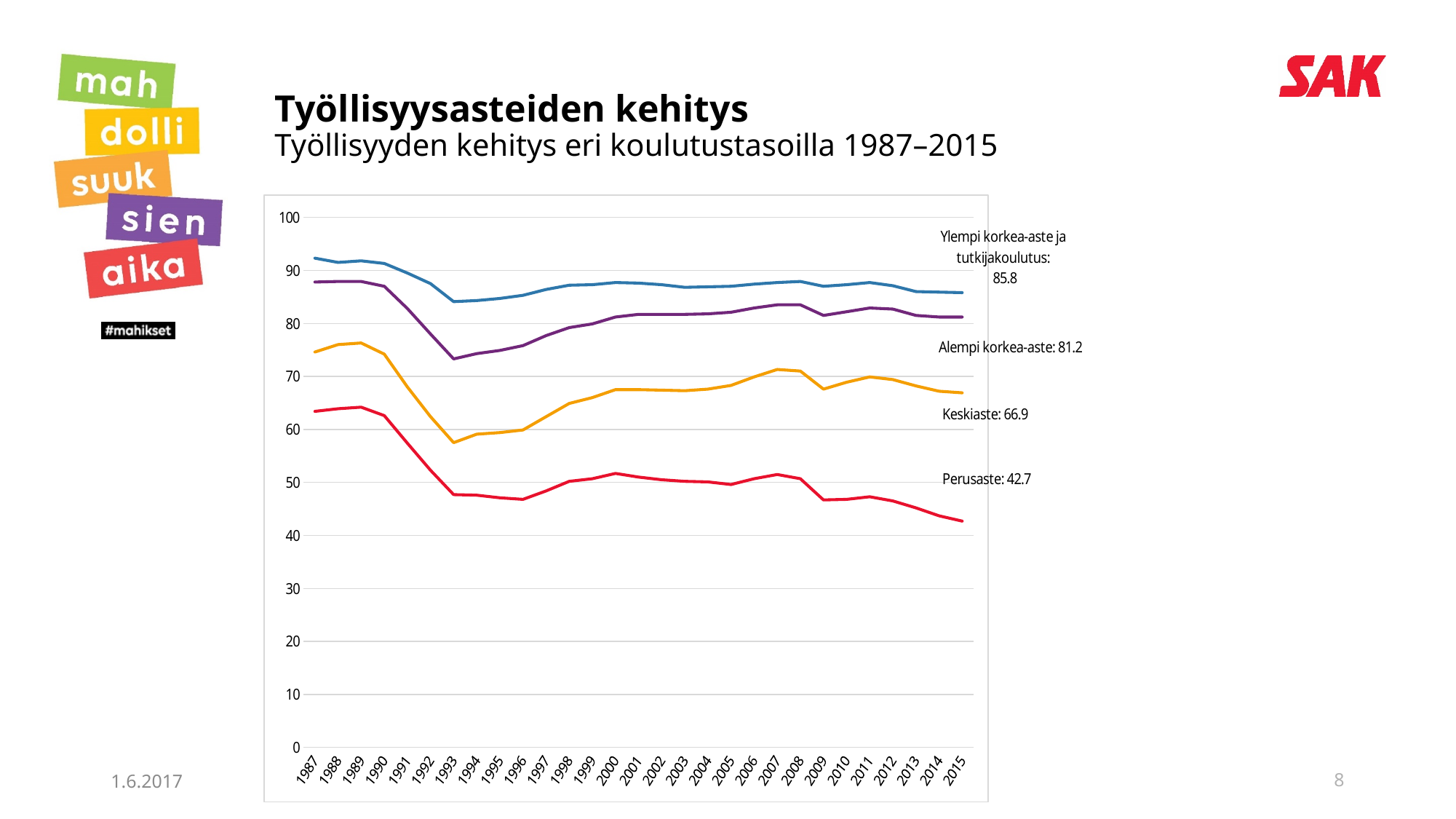
What is the 2015 value for Ylempi korkea-aste ja tutkijakoulutus? 85.8 Is the value for Perusaste in 1987 greater or less than 60? greater What type of chart is shown on the slide? line chart What is the 2015 value for Perusaste? 42.7 What is the difference between the 2015 values for Ylempi korkea-aste ja tutkijakoulutus and Perusaste? 43.1 Which education level has the lowest employment rate in 2015? Perusaste What is the 2015 value for Alempi korkea-aste? 81.2 What is the difference between the 2015 values for Alempi korkea-aste and Keskiaste? 14.3 Does the Perusaste line rise or fall between 1990 and 1993? fall Which education level has the highest employment rate in 2015? Ylempi korkea-aste ja tutkijakoulutus How many years are shown on the x axis? 29 What is the 2015 value for Keskiaste? 66.9